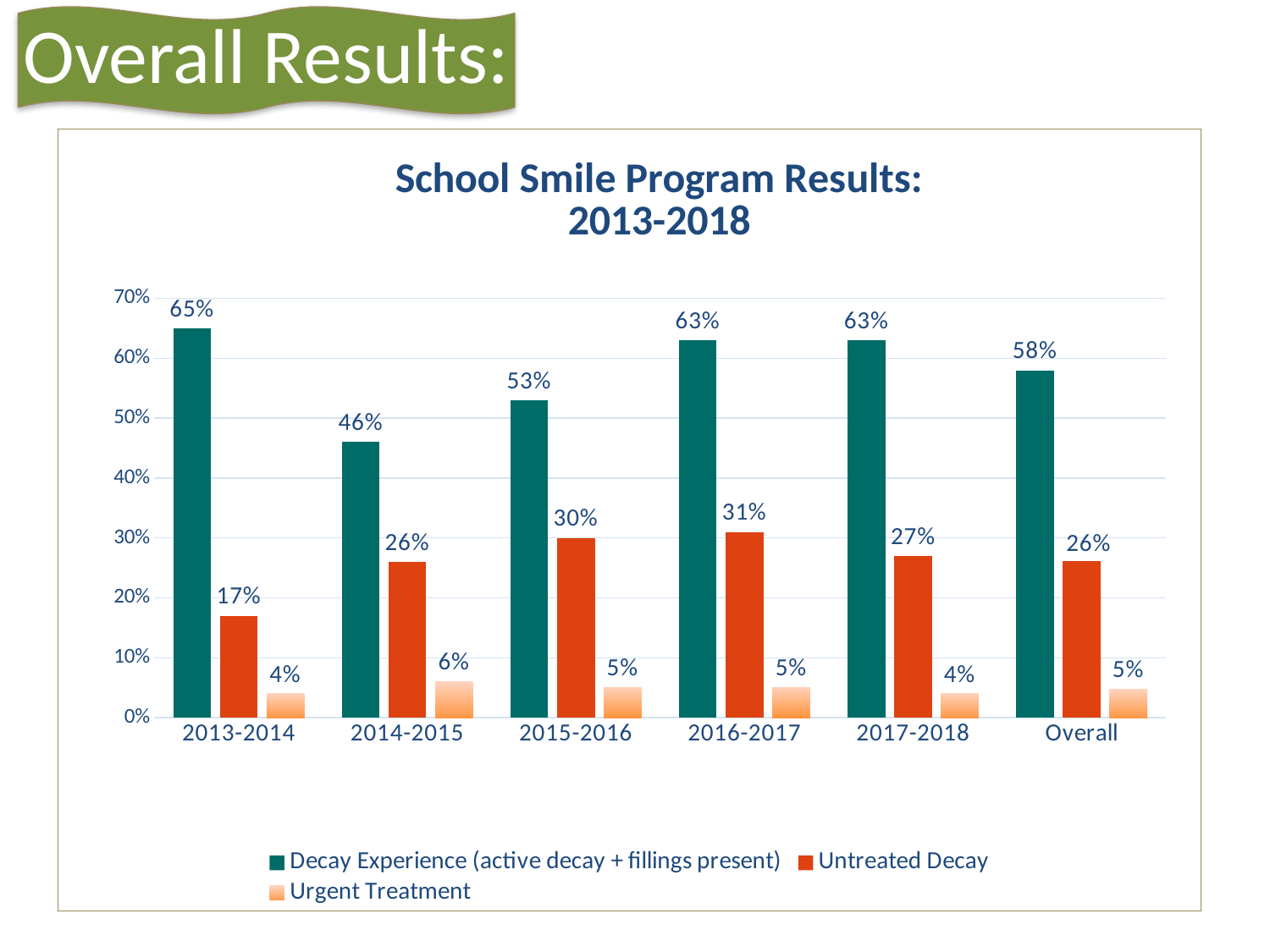
What kind of chart is shown? Bar chart What is the title of the chart? School Smile Program Results: 2013-2018 Which is larger, the Untreated Decay value for 2015-2016 or for 2017-2018? 2015-2016 How many categories are shown on the x axis? 6 What is the Overall value for Untreated Decay? 26% Which category has the highest Untreated Decay value? 2016-2017 How many series does the legend list? 3 What is the Untreated Decay value for 2016-2017? 31% What is the Urgent Treatment value for 2014-2015? 6% What is the difference between the Decay Experience values for 2013-2014 and 2014-2015? 19% Which category has the lowest Decay Experience value? 2014-2015 What is the Decay Experience value for 2013-2014? 65%